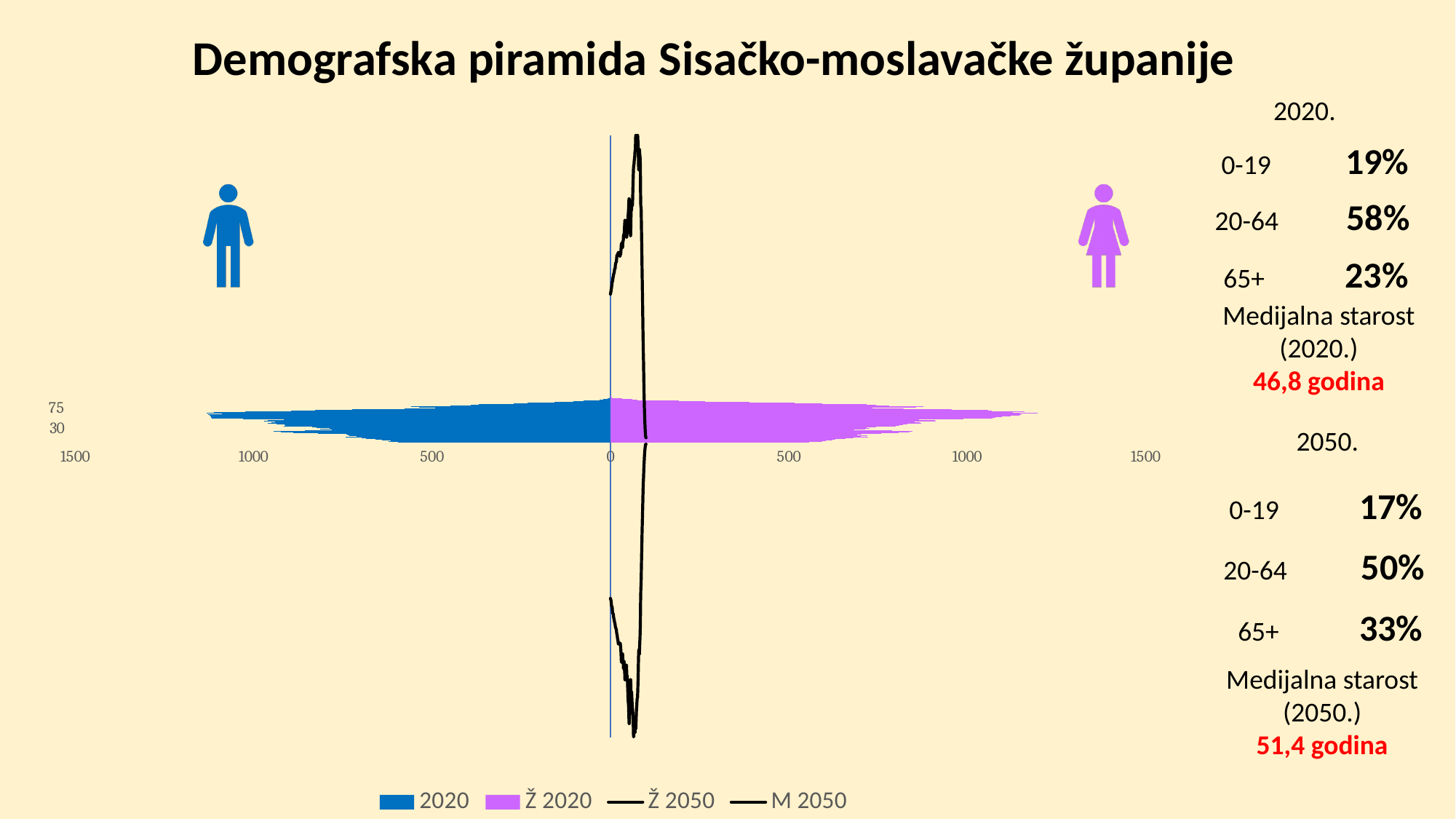
What kind of chart is the demographic pyramid drawn as? bar chart What is the largest value shown on the horizontal axis of the chart? 1500 What is the title of the chart? Demografska piramida Sisačko-moslavačke županije How many series does the chart legend list? 4 Which series in the legend is shown in blue? 2020